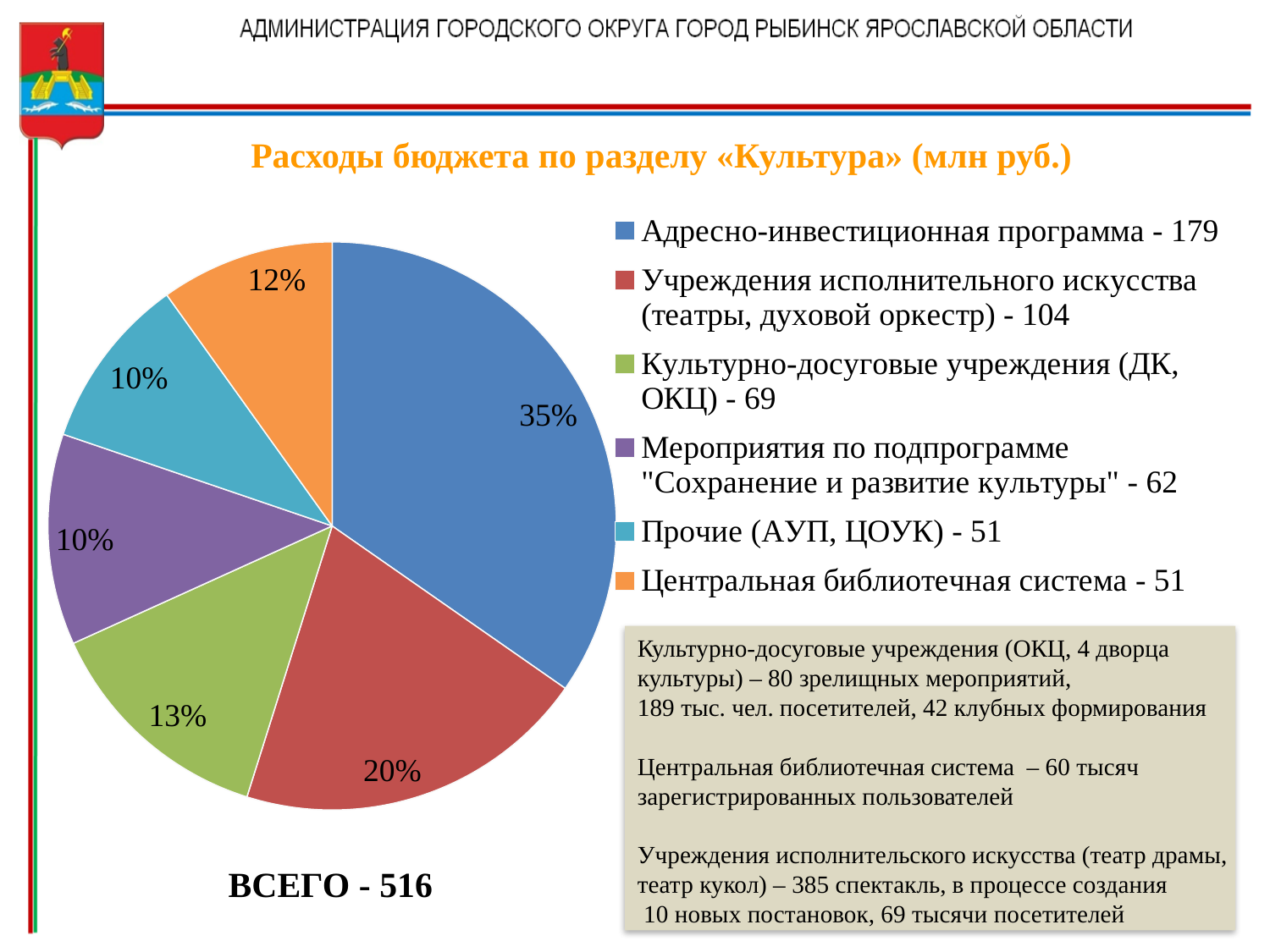
What total (ВСЕГО) is shown below the pie chart? 516 What kind of chart is shown on the slide? pie chart What share of the pie does «Адресно-инвестиционная программа» take? 35% Which category has the largest slice of the pie? Адресно-инвестиционная программа What is the difference between the values for «Адресно-инвестиционная программа» (179) and «Учреждения исполнительного искусства» (104)? 75 What share of the pie does «Культурно-досуговые учреждения (ДК, ОКЦ)» take? 13% What share of the pie does «Учреждения исполнительного искусства (театры, духовой оркестр)» take? 20% What value (млн руб.) is given in the legend for «Мероприятия по подпрограмме "Сохранение и развитие культуры"»? 62 How many slices does the pie chart have? 6 What value (млн руб.) is given in the legend for «Адресно-инвестиционная программа»? 179 How many entries does the legend list? 6